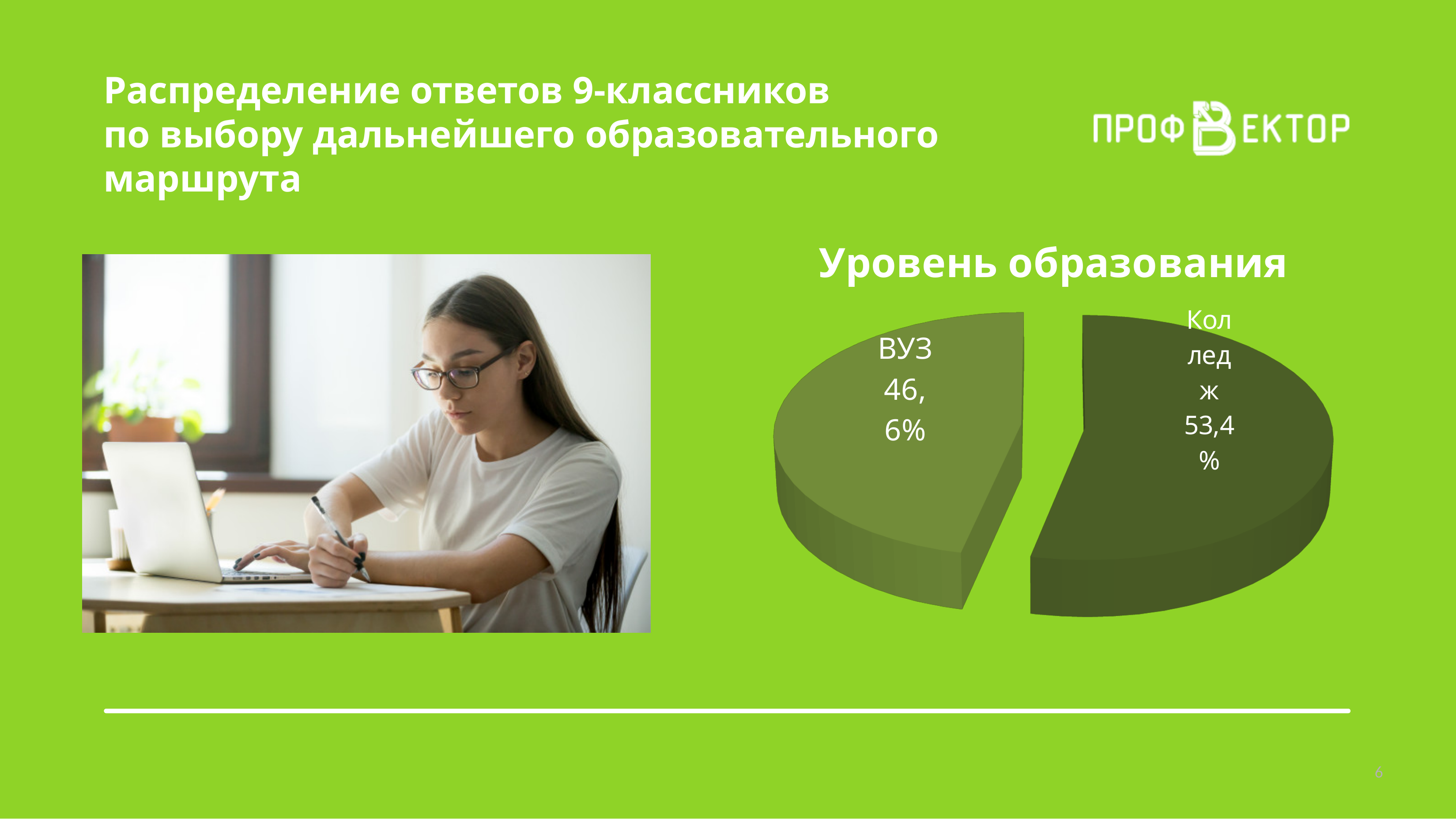
What kind of chart is shown on the slide? pie chart Which slice of the pie chart is the smallest? ВУЗ What is the title of the pie chart? Уровень образования How many slices does the pie chart have? 2 What share of the pie chart is labelled ВУЗ? 46,6% What share of the pie chart is labelled Колледж? 53,4% Which slice of the pie chart is the largest? Колледж Which is larger in the pie chart, ВУЗ or Колледж? Колледж Is the share for ВУЗ greater or less than 50%? less By how many percentage points does Колледж exceed ВУЗ in the pie chart? 6,8 Is the share for Колледж greater or less than 50%? greater